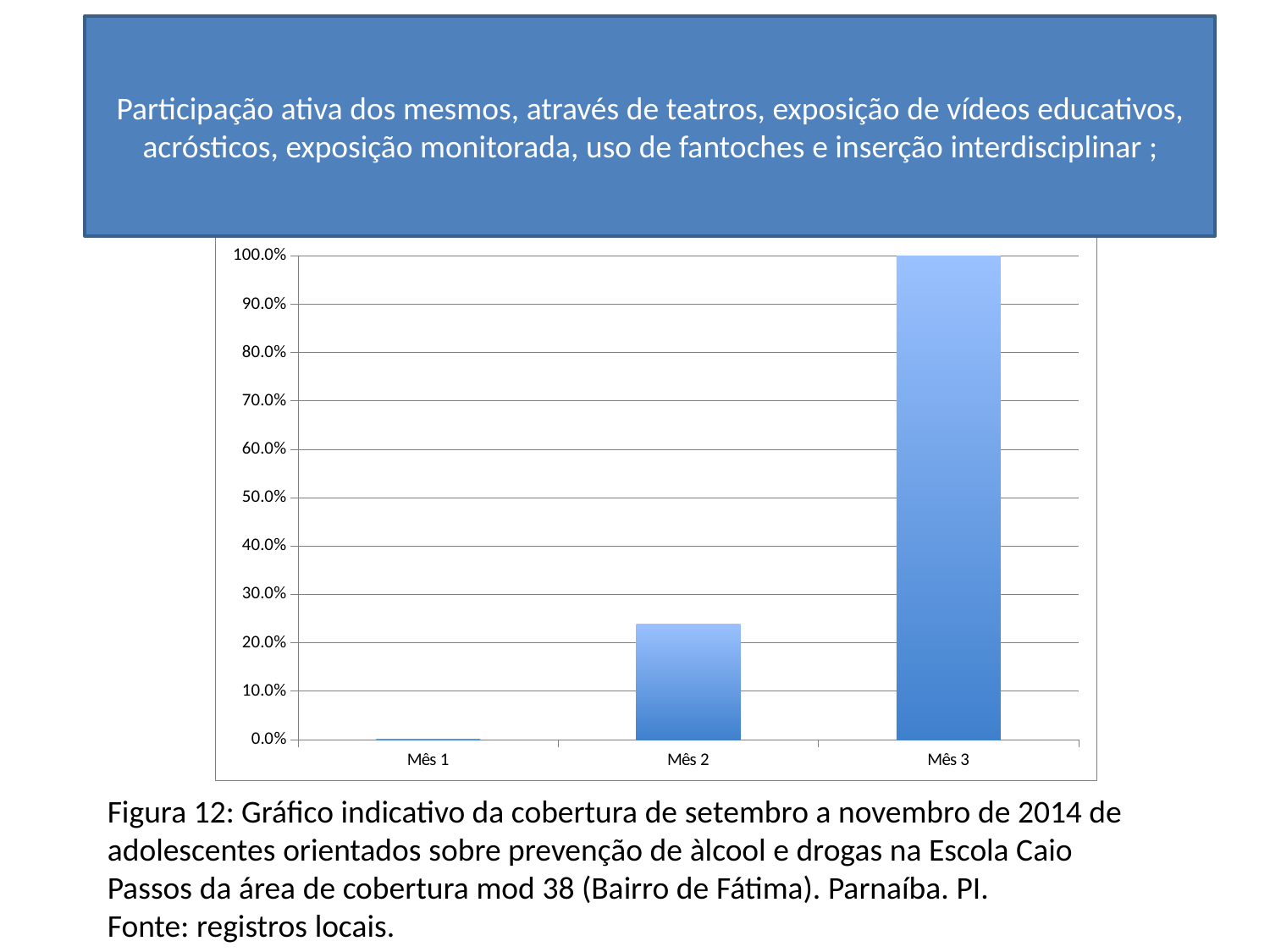
Which is larger, the value for Mês 2 or the value for Mês 3? Mês 3 Is the value for Mês 2 greater or less than 20.0%? greater What is the value for Mês 3 in the chart? 100.0% How many categories are plotted on the x axis of the chart? 3 Do the values rise or fall from Mês 1 to Mês 3? rise Is the value for Mês 1 greater or less than 10.0%? less Which category has the highest value in the chart? Mês 3 What kind of chart is shown on the slide? bar chart Is the value for Mês 2 greater or less than 30.0%? less What is the label of the first category on the x axis? Mês 1 Which category has the lowest value in the chart? Mês 1 What is the highest tick value shown on the y axis of the chart? 100.0%